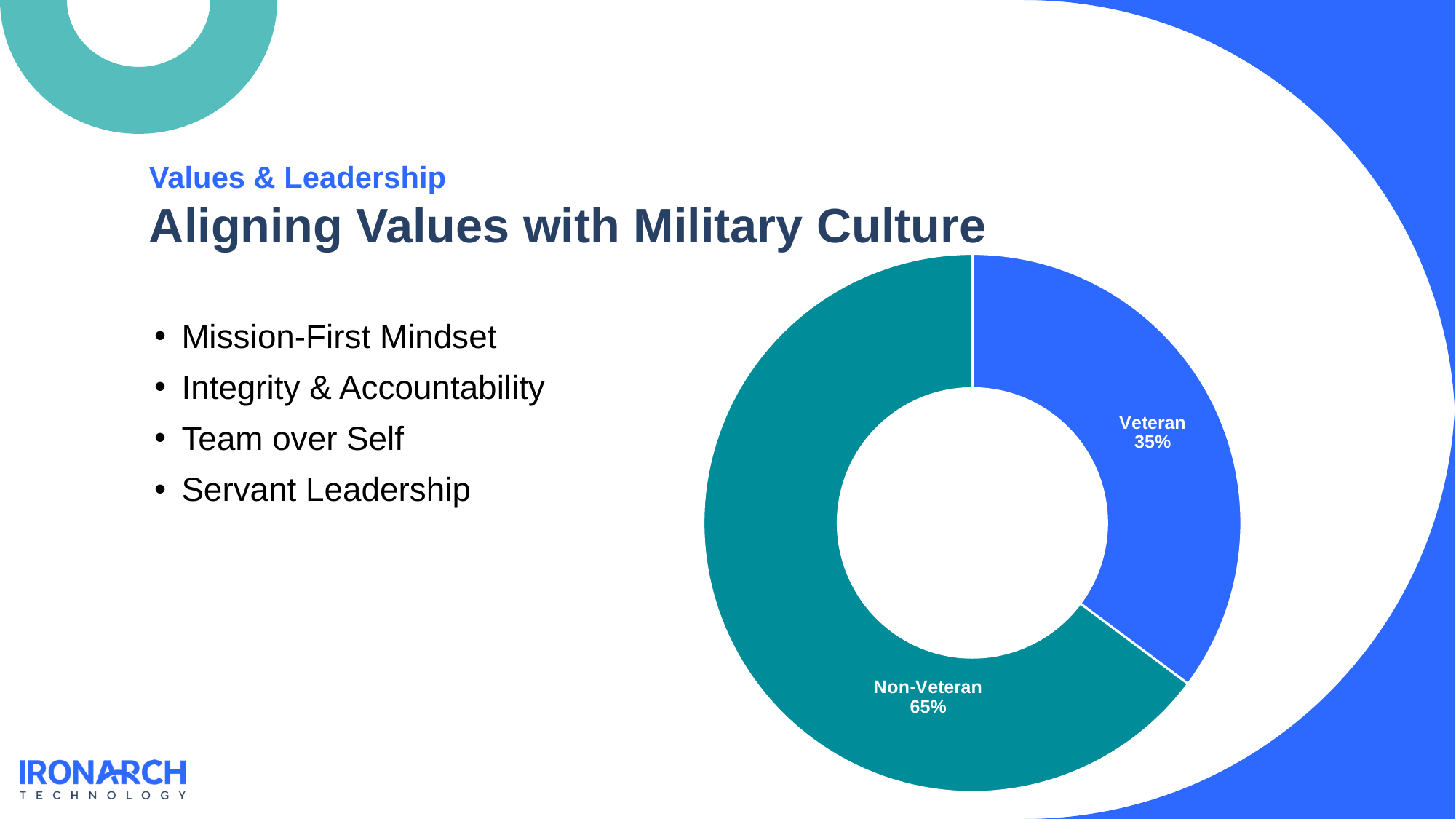
How many categories are shown in the donut chart? 2 Which category has the largest share in the donut chart? Non-Veteran What share of the donut chart is labelled Veteran? 35% Which is larger, the Veteran share or the Non-Veteran share? Non-Veteran Is the Veteran share greater or less than 50%? less What share of the donut chart is labelled Non-Veteran? 65% What kind of chart is shown on the slide? Donut chart What colour is the Veteran segment of the donut chart? Blue Which category has the smallest share in the donut chart? Veteran What is the difference in percentage points between the Non-Veteran and Veteran shares? 30 What colour is the Non-Veteran segment of the donut chart? Teal